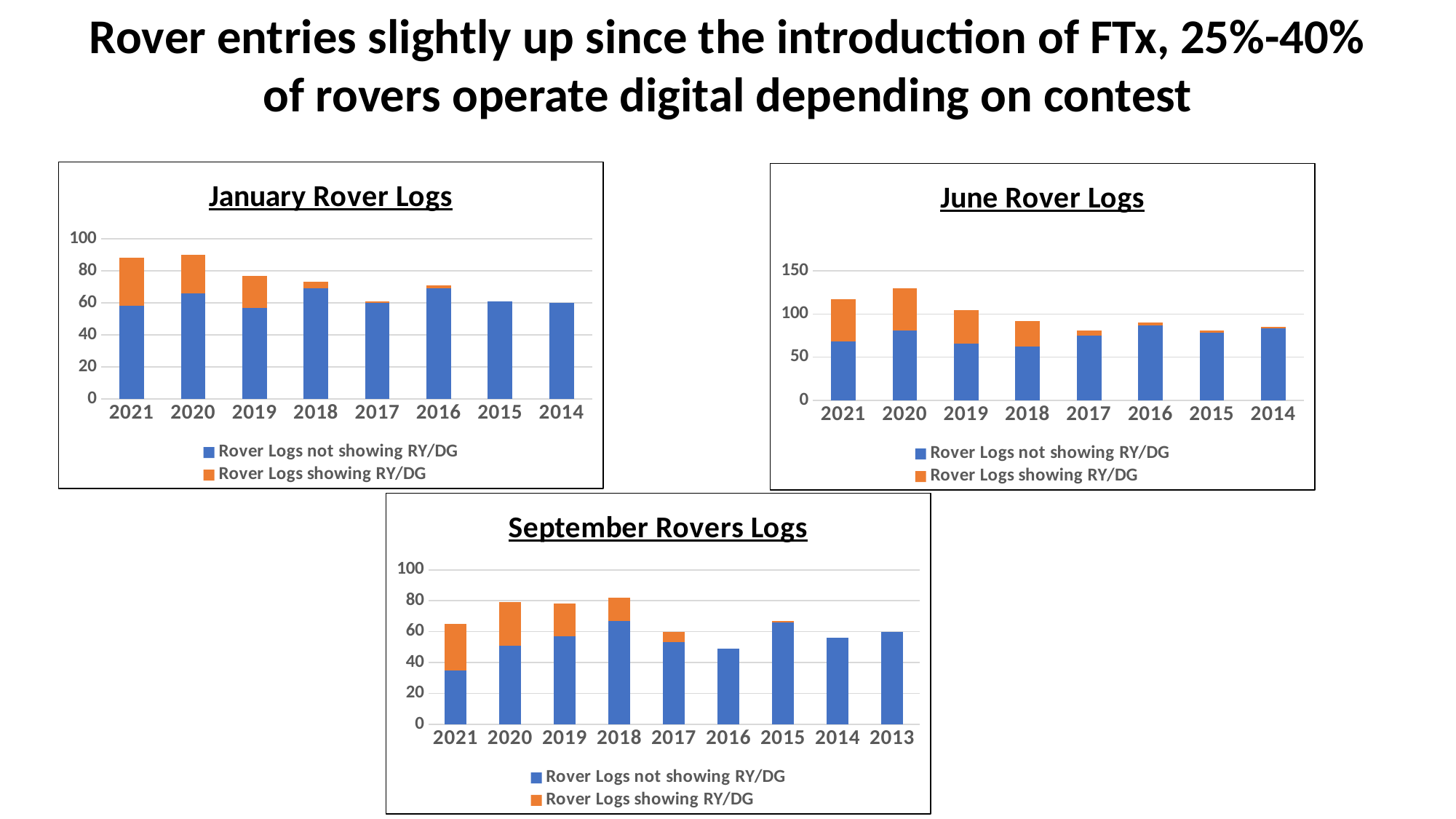
How many years are shown on the x axis of the September Rovers Logs chart? 9 In the June Rover Logs chart, is the total bar for 2021 larger or smaller than the total bar for 2014? larger In the June Rover Logs chart, is the total bar for 2020 greater or less than 100? greater In the June Rover Logs chart, which year has the tallest total bar? 2020 In the September Rovers Logs chart, which year has the shortest total bar? 2016 In the September Rovers Logs chart, which year has the smallest value for Rover Logs not showing RY/DG? 2021 How many series does the legend of the January Rover Logs chart list? 2 What are the two legend entries in the June Rover Logs chart? Rover Logs not showing RY/DG; Rover Logs showing RY/DG In the September Rovers Logs chart, is the total bar for 2016 greater or less than 60? less In the September Rovers Logs chart, which year has the larger value for Rover Logs not showing RY/DG, 2021 or 2020? 2020 How many years are shown on the x axis of the June Rover Logs chart? 8 What type of chart is the January Rover Logs chart? Stacked bar chart